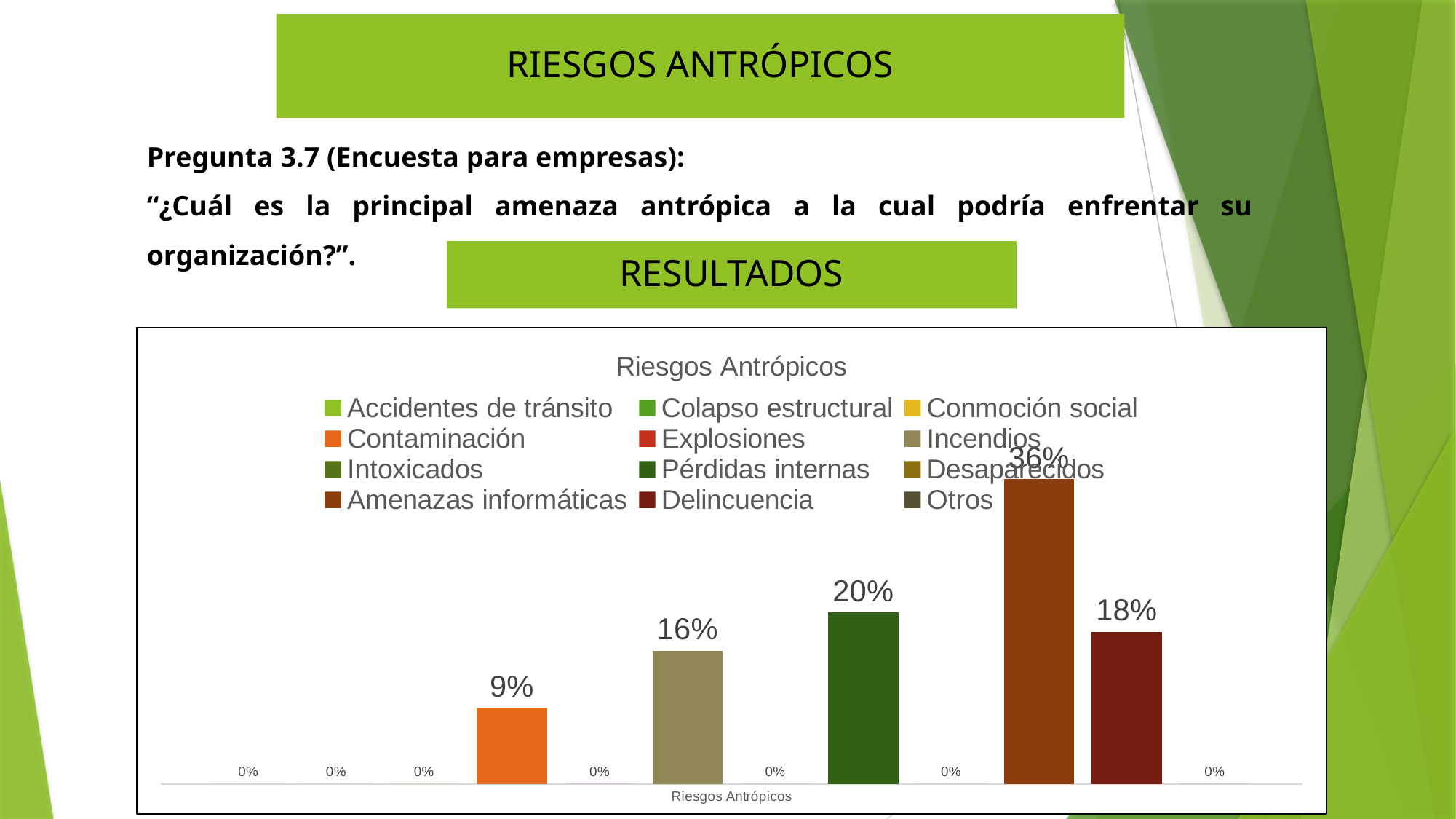
What is the difference between the values for Delincuencia and Contaminación? 9% Which is larger, the value for Pérdidas internas or the value for Delincuencia? Pérdidas internas What is the title of the chart? Riesgos Antrópicos What is the value for Contaminación? 9% What kind of chart is shown on the slide? Bar chart Which category has the highest value? Amenazas informáticas What is the value for Delincuencia? 18% What is the value for Pérdidas internas? 20% What is the value for Incendios? 16% How many series does the legend list? 12 What is the value for Amenazas informáticas? 36% What is the difference between the values for Amenazas informáticas and Pérdidas internas? 16%